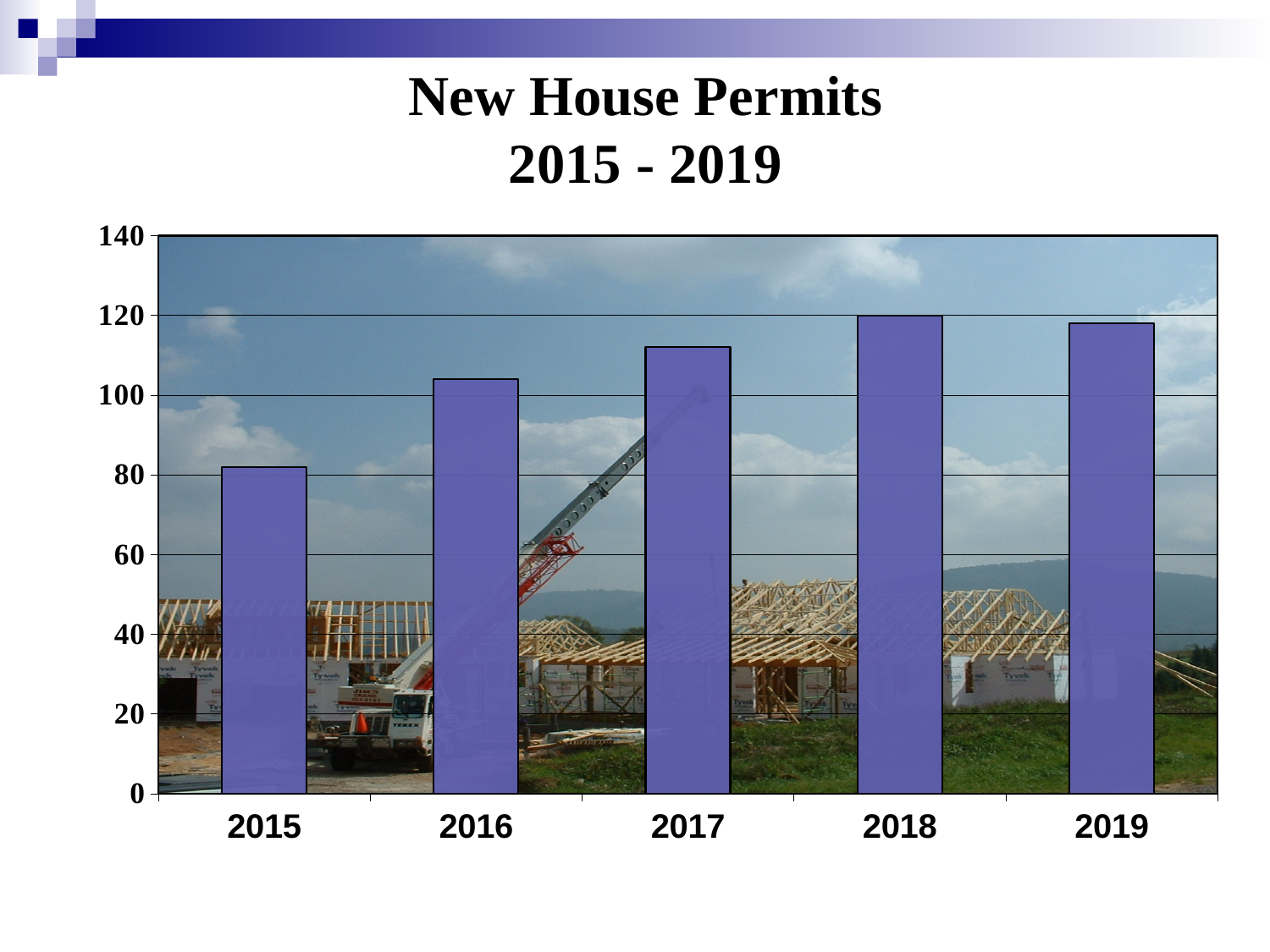
Is the value for 2018 greater or less than 100? greater How many years are shown on the x axis of the chart? 5 What is the title of the chart? New House Permits 2015 - 2019 Which year has more new house permits, 2015 or 2016? 2016 Is the value for 2019 greater or less than 100? greater Which year has more new house permits, 2017 or 2015? 2017 What kind of chart is shown on the slide? bar chart Is the value for 2016 greater or less than 100? greater Do the values generally rise or fall from 2015 to 2018? rise Which year has the lowest number of new house permits? 2015